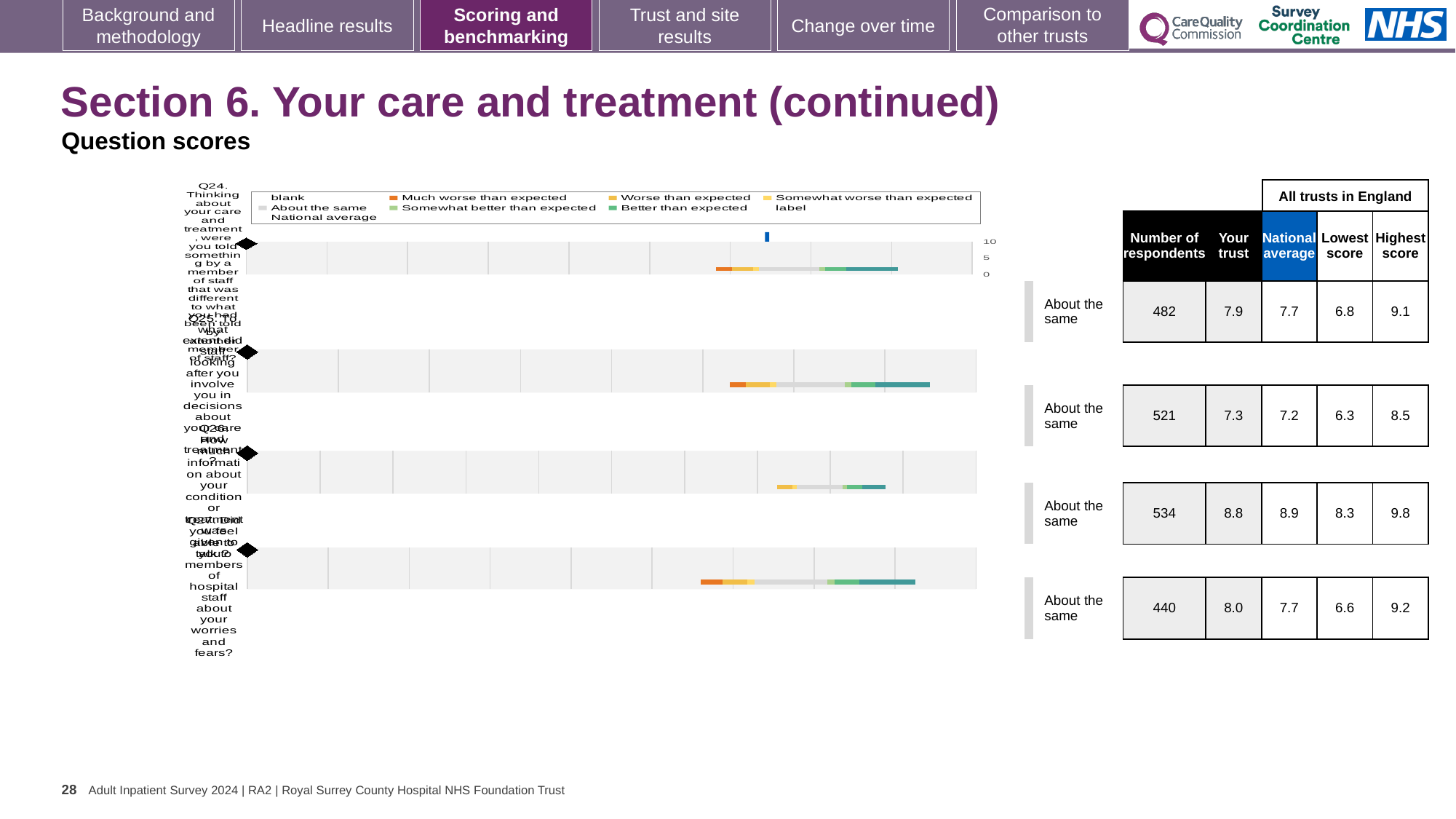
For the fourth (bottom) question chart, what is the lowest score among all trusts in England? 6.6 In the chart legend, which colour represents 'Better than expected'? green For the first (top) question chart, what is the trust's score shown in the 'Your trust' column? 7.9 For the third question chart, what is the highest score among all trusts in England? 9.8 In the chart legend, which colour represents 'Much worse than expected'? orange How many question score charts are shown on the slide? 4 For the first (top) question chart, what is the number of respondents? 482 What is the difference between the trust score and the national average for the fourth (bottom) question chart? 0.3 What kind of chart is used to show the question scores on this slide? bar chart Which question chart has the highest 'Your trust' score? the third chart (8.8) For the second question chart, what is the national average score? 7.2 For the third question chart, is the trust score or the national average larger? national average (8.9)